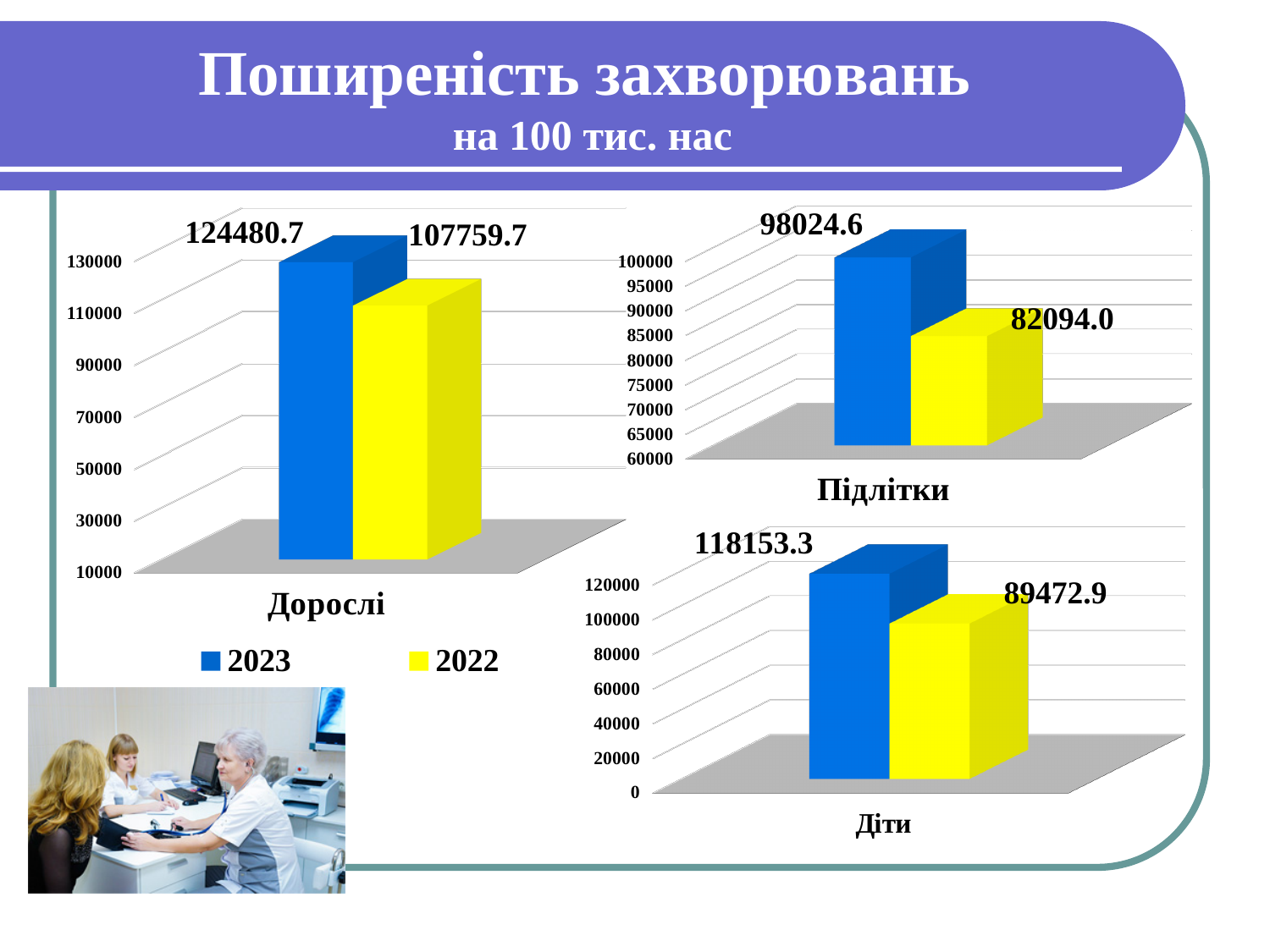
What kind of chart is the chart titled "Підлітки"? Bar chart In the chart titled "Підлітки", what is the value for 2022? 82094.0 How many series does the legend of the chart titled "Дорослі" list? 2 In the chart titled "Підлітки", what is the value for 2023? 98024.6 In the chart titled "Діти", is the value for 2022 greater or less than 100000? less In the chart titled "Діти", what is the difference between the 2023 and 2022 values? 28680.4 In the chart titled "Дорослі", what is the difference between the 2023 and 2022 values? 16721.0 In the chart titled "Діти", what is the value for 2023? 118153.3 In the chart titled "Дорослі", what is the value for 2022? 107759.7 In the chart titled "Діти", what is the value for 2022? 89472.9 In the chart titled "Дорослі", what is the value for 2023? 124480.7 In the chart titled "Підлітки", which year has the larger value, 2023 or 2022? 2023